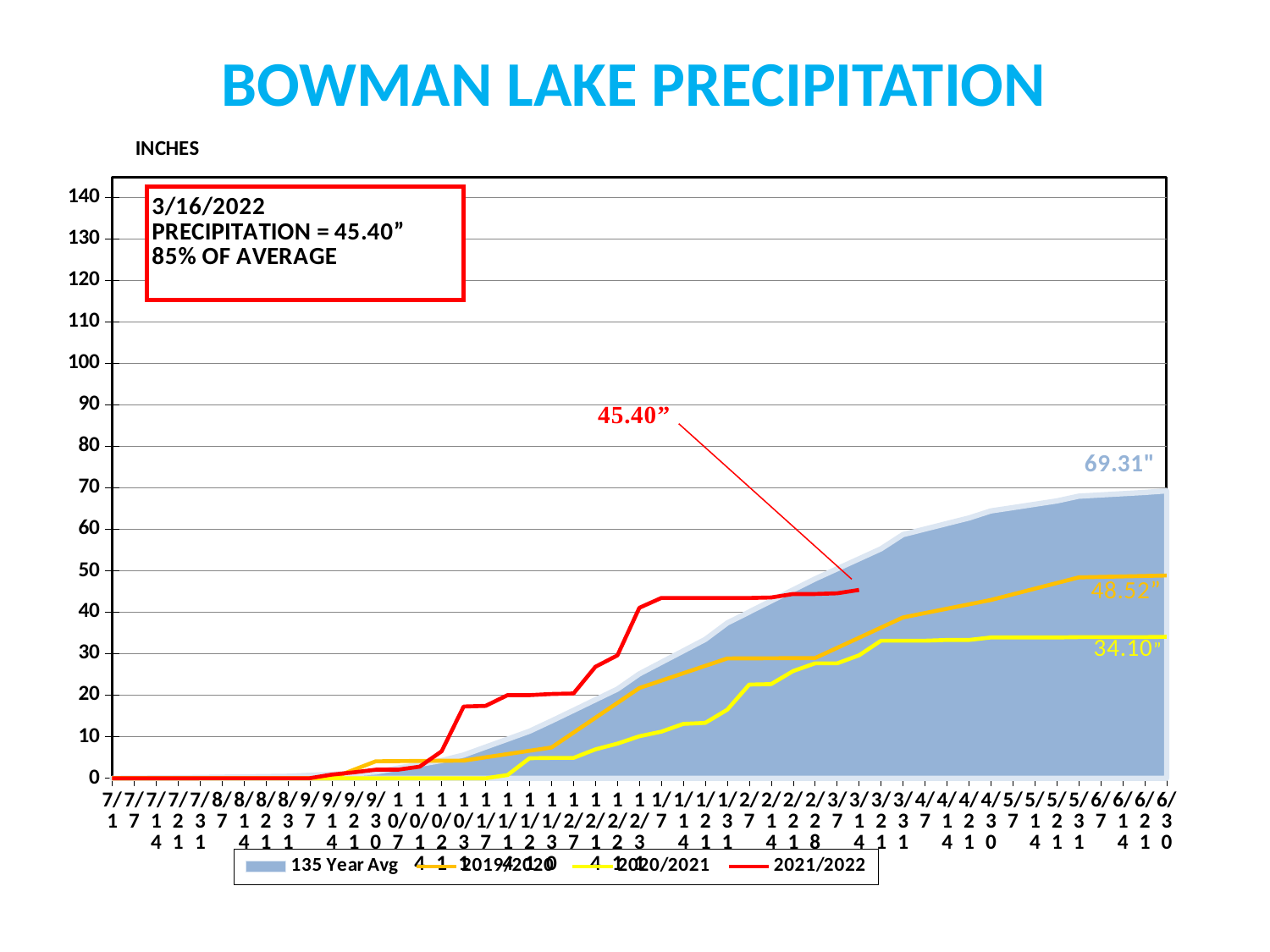
What is the final value labelled for the 2020/2021 series? 34.10" According to the text box, the 3/16/2022 precipitation is what percent of average? 85% What is the final value labelled for the 2019/2020 series? 48.52" What precipitation value is labelled for the 2021/2022 series as of 3/16/2022? 45.40" Do the plotted values rise or fall along the x axis? rise What is the difference between the final 2019/2020 value (48.52") and the final 2020/2021 value (34.10")? 14.42" What is the final value labelled for the 135 Year Avg series? 69.31" Which series ends higher, 2019/2020 or 2020/2021? 2019/2020 What is the difference between the final 135 Year Avg value (69.31") and the final 2019/2020 value (48.52")? 20.79" Which series ends at the lowest value? 2020/2021 Which series ends at the highest value? 135 Year Avg How many series does the legend list? 4